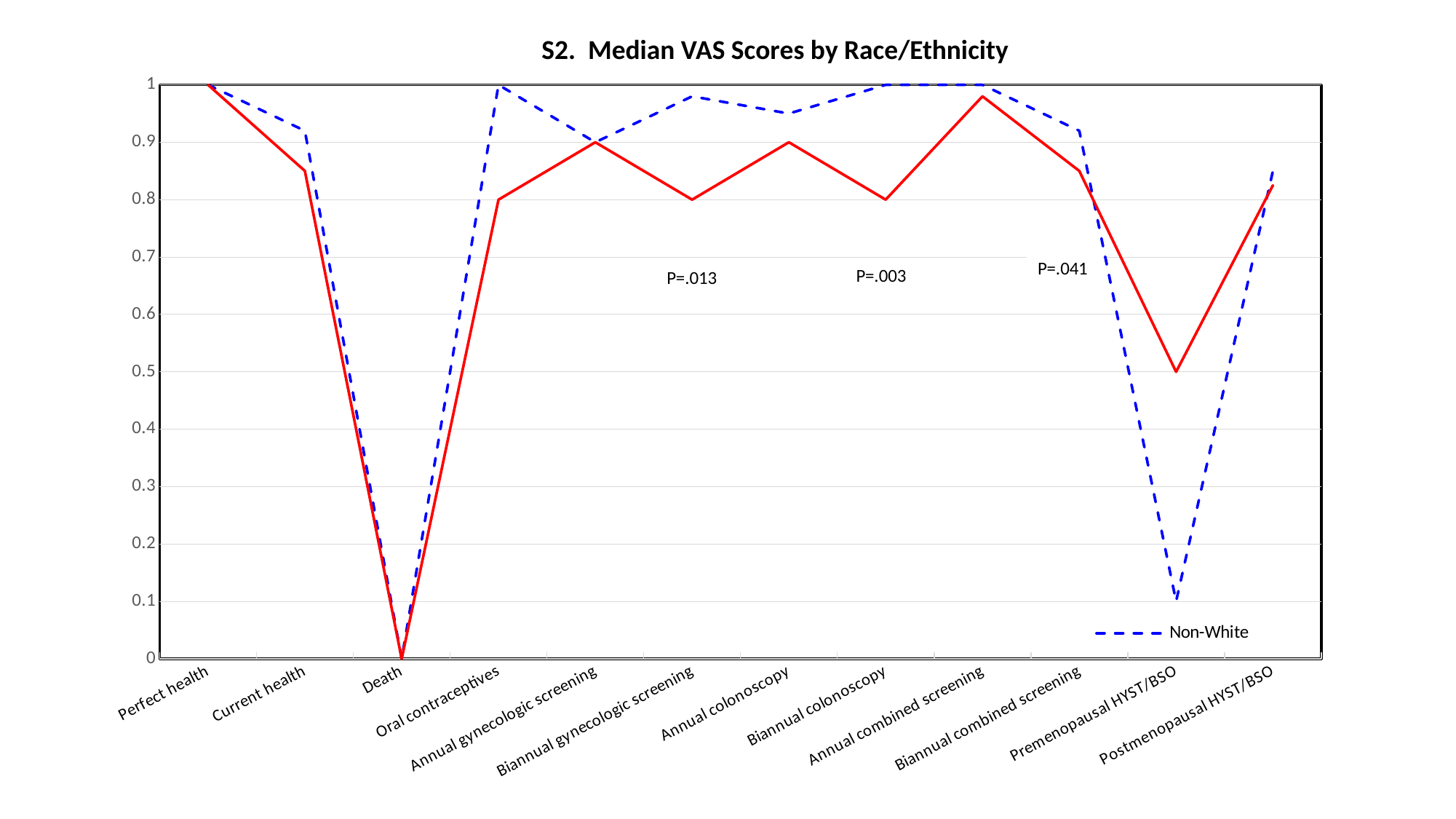
What is the Non-White median VAS score for Death? 0 What is the title of the chart? S2. Median VAS Scores by Race/Ethnicity What is the Non-White median VAS score for Oral contraceptives? 1 For the Non-White series, which is larger: Premenopausal HYST/BSO or Postmenopausal HYST/BSO? Postmenopausal HYST/BSO Is the Non-White value for Premenopausal HYST/BSO greater or less than 0.2? less How many series does the chart's legend list? 1 What P-value is annotated on the chart near Biannual colonoscopy? P=.003 How many categories are shown along the x axis of the chart? 12 Which category has the lowest Non-White median VAS score? Death What is the Non-White median VAS score for Perfect health? 1 Is the Non-White value for Current health greater or less than 0.8? greater What type of chart is shown on the slide? Line chart